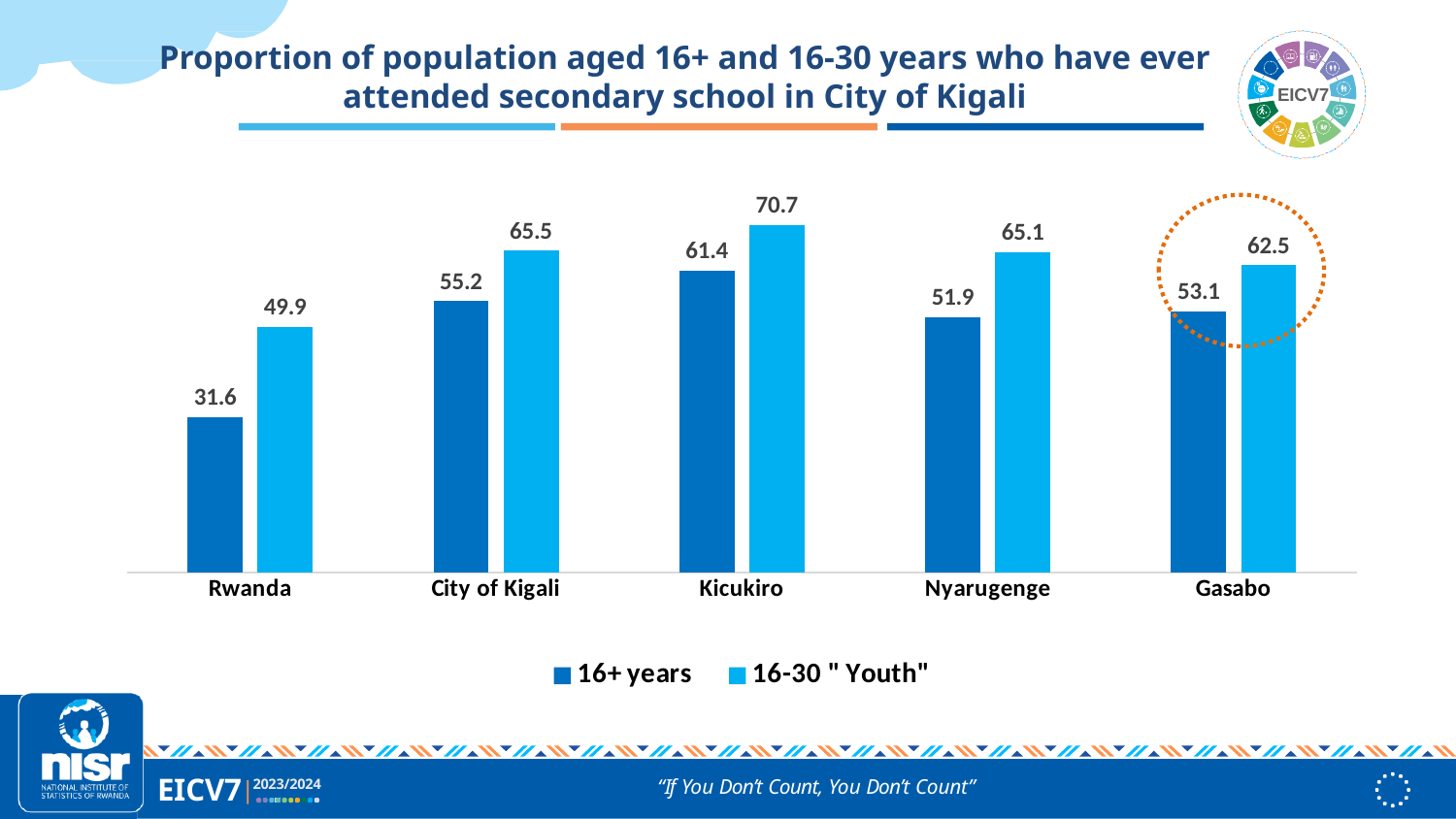
How many series does the legend list? 2 What is the value for the 16+ years series in Rwanda? 31.6 Which category is highlighted with a dashed orange circle? Gasabo What is the difference between the 16-30 "Youth" values for Kicukiro and Nyarugenge? 5.6 Which category has the lowest value for the 16+ years series? Rwanda Which category has the highest value for the 16-30 "Youth" series? Kicukiro What is the value for the 16+ years series in Gasabo? 53.1 What is the difference between the 16-30 "Youth" and 16+ years values for Rwanda? 18.3 What kind of chart is shown on the slide? Bar chart What is the value for the 16-30 "Youth" series in Kicukiro? 70.7 Which is larger: the 16+ years value for Kicukiro or the 16+ years value for City of Kigali? Kicukiro How many categories are shown on the x axis? 5